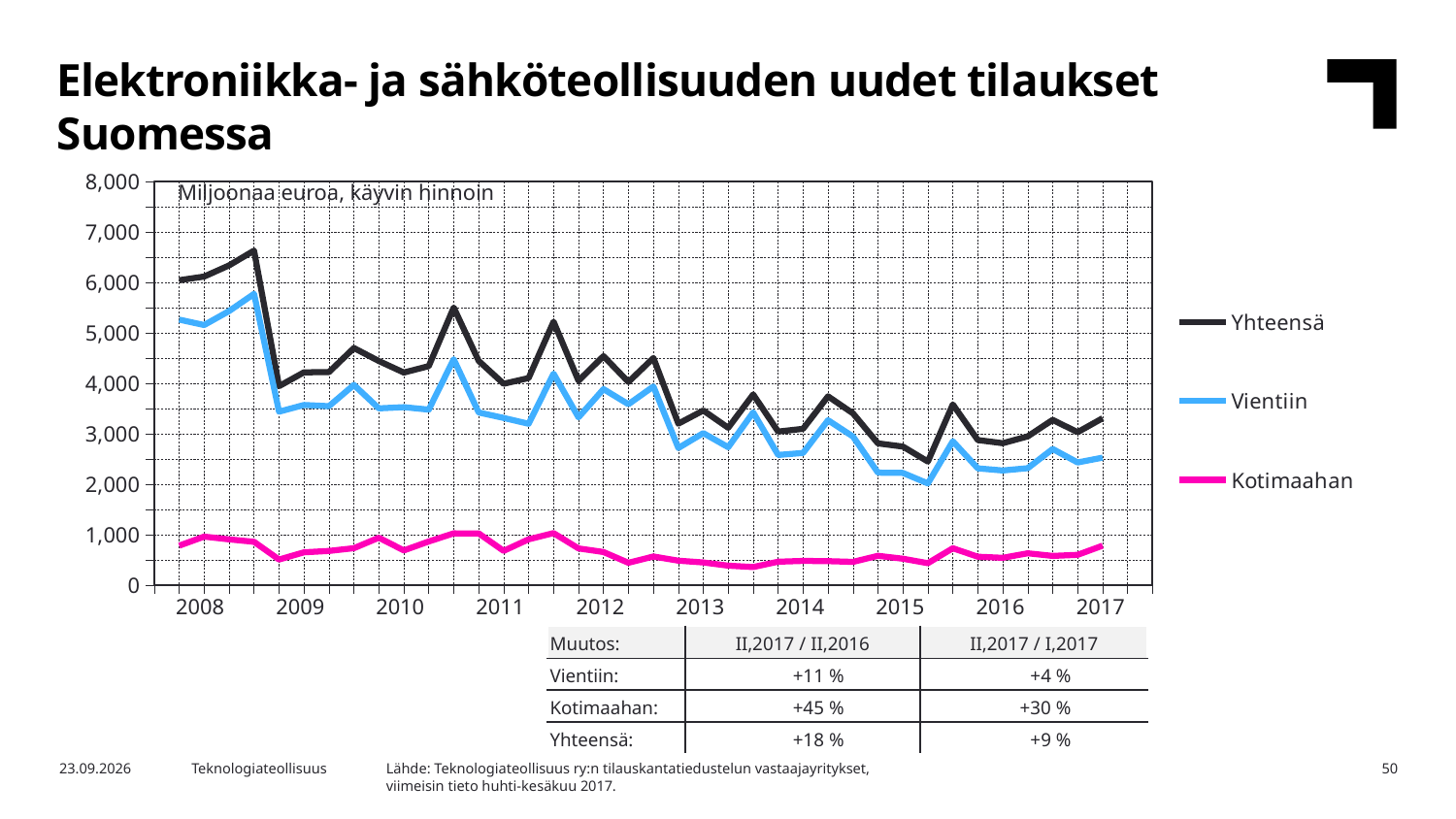
How many series does the chart legend list? 3 What unit label is shown at the top of the chart's plot area? Miljoonaa euroa, käyvin hinnoin Is the value of the Vientiin series in 2016 greater or less than 3,000? less Overall, do the Yhteensä values rise or fall from 2008 to 2017? fall Is the peak value of the Yhteensä series in 2008 greater or less than 6,000? greater What are the three series named in the chart legend? Yhteensä, Vientiin, Kotimaahan What kind of chart is shown on the slide? line chart Which series has the lowest values throughout the chart? Kotimaahan Is the peak value of the Yhteensä series in 2010 greater or less than 5,000? greater Which series has the highest values throughout the chart? Yhteensä Which series is larger in 2013, Vientiin or Kotimaahan? Vientiin